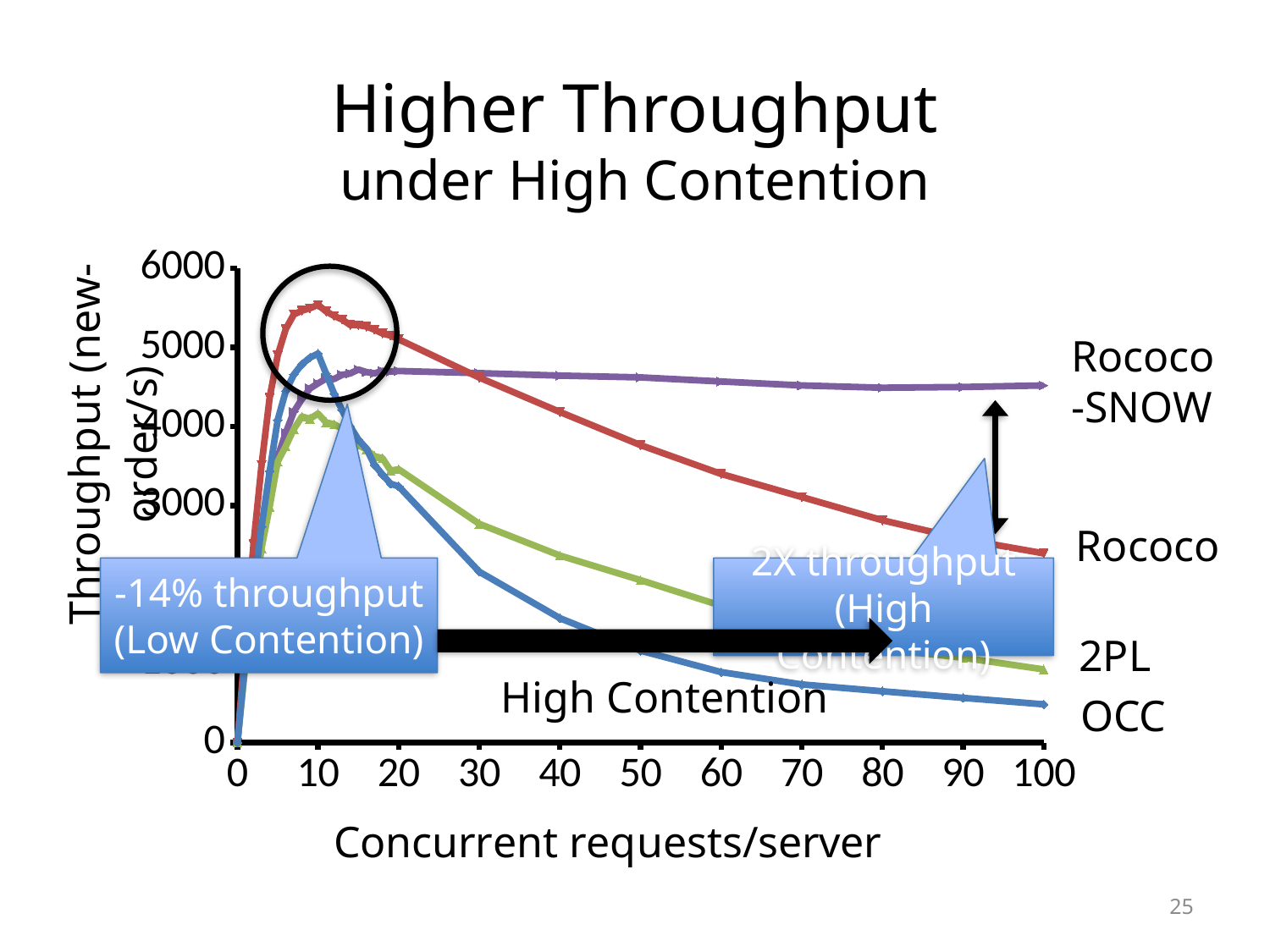
Is the throughput of OCC at 100 concurrent requests/server greater or less than 1000? less Which series has the lowest throughput at 100 concurrent requests/server? OCC Does the throughput of OCC rise or fall as concurrent requests/server increase from 10 to 100? fall Is the throughput of Rococo-SNOW at 100 concurrent requests/server greater or less than 4000? greater Which series has the highest throughput at 100 concurrent requests/server? Rococo-SNOW How many series are plotted in the chart? 4 What is the label of the x axis? Concurrent requests/server At 100 concurrent requests/server, which has higher throughput: Rococo or 2PL? Rococo Is the peak throughput of Rococo greater or less than 5000? greater At 50 concurrent requests/server, which has higher throughput: Rococo-SNOW or Rococo? Rococo-SNOW What kind of chart is shown on the slide? line chart